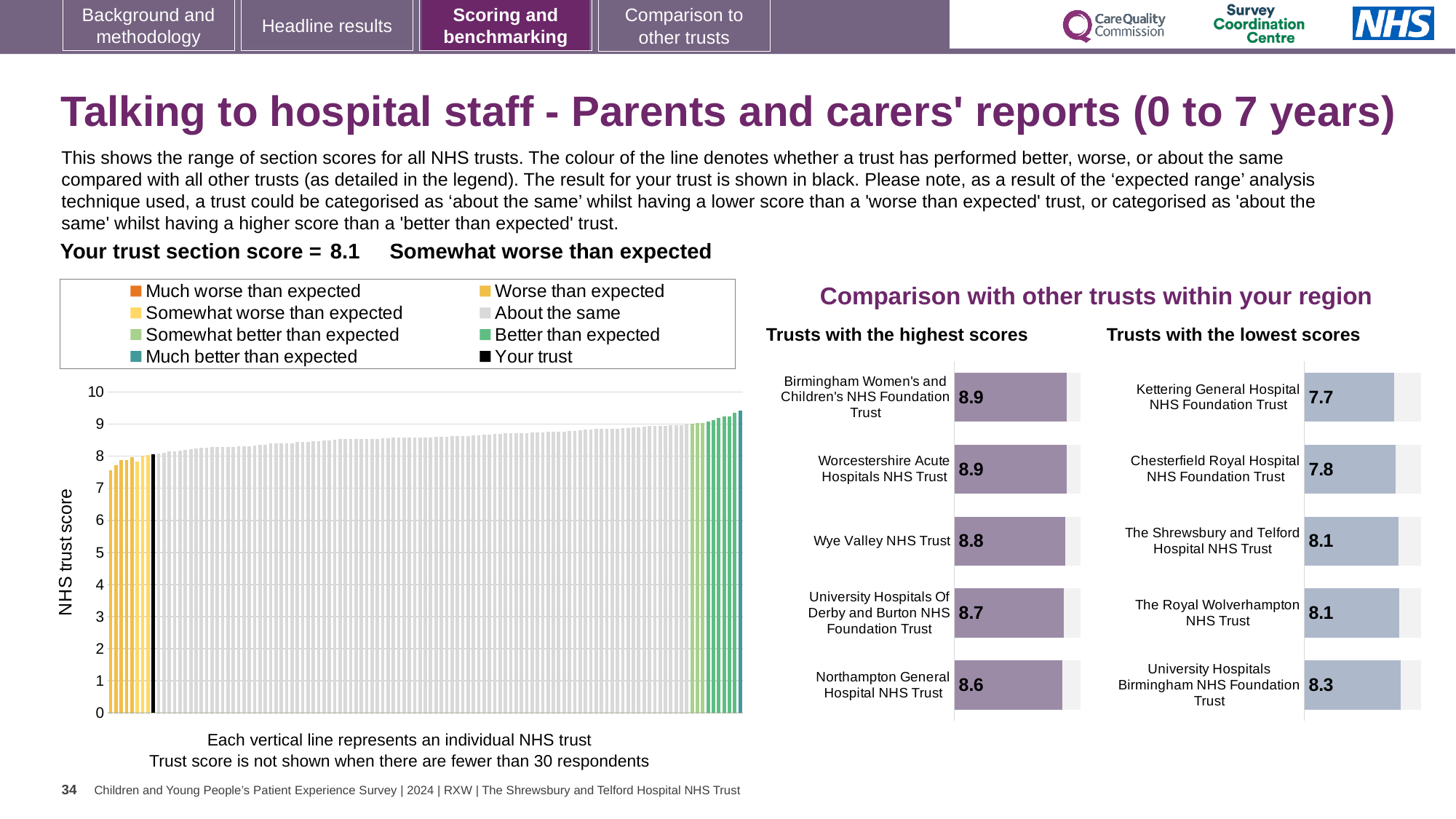
Which has a higher score: Wye Valley NHS Trust in the 'highest scores' chart or Chesterfield Royal Hospital NHS Foundation Trust in the 'lowest scores' chart? Wye Valley NHS Trust How many entries does the legend of the large chart on the left list? 8 In the 'Trusts with the lowest scores' chart, which trust has the highest score? University Hospitals Birmingham NHS Foundation Trust In the large chart on the left showing all NHS trusts, what is the section score for your trust (the black bar)? 8.1 In the 'Trusts with the lowest scores' chart, what is the score for Kettering General Hospital NHS Foundation Trust? 7.7 How many trusts are shown in the 'Trusts with the lowest scores' chart? 5 In the 'Trusts with the highest scores' chart, which trust has the lowest score? Northampton General Hospital NHS Trust In the 'Trusts with the lowest scores' chart, what is the difference between the scores of University Hospitals Birmingham NHS Foundation Trust and Kettering General Hospital NHS Foundation Trust? 0.6 In the 'Trusts with the highest scores' chart, what is the difference between the scores of Birmingham Women's and Children's NHS Foundation Trust and Northampton General Hospital NHS Trust? 0.3 In the 'Trusts with the highest scores' chart, what is the score for Wye Valley NHS Trust? 8.8 In the large chart on the left showing all NHS trusts, is the value of the tallest bar greater or less than 9? greater What kind of chart is the large chart on the left showing all NHS trusts? Bar chart